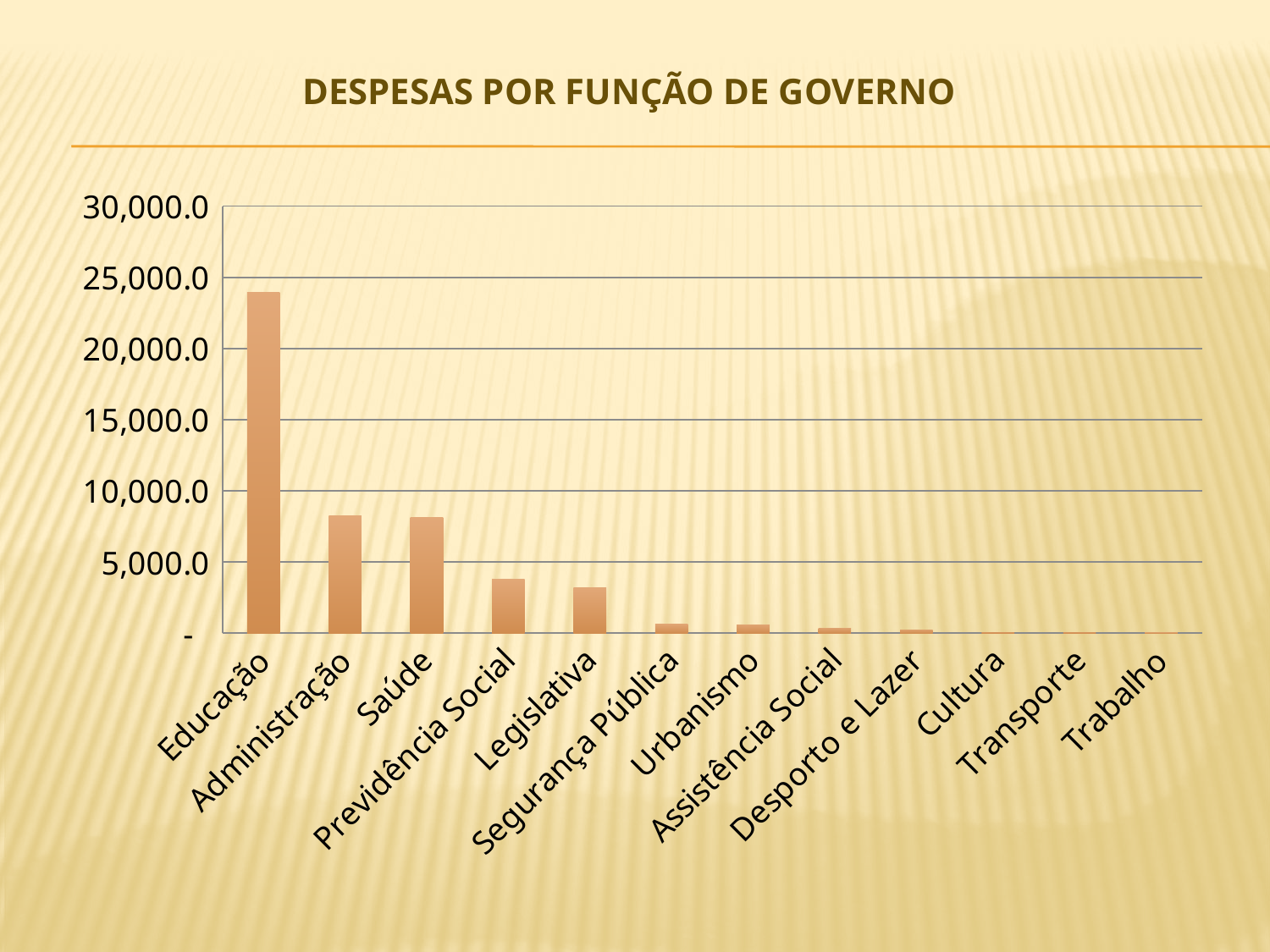
Which is larger, the value for Previdência Social or the value for Segurança Pública? Previdência Social Which is larger, the value for Educação or the value for Administração? Educação What is the title of the chart? DESPESAS POR FUNÇÃO DE GOVERNO Is the value for Legislativa greater or less than 5,000.0? less Is the value for Educação greater or less than 20,000.0? greater Is the value for Administração greater or less than 10,000.0? less Do the values generally rise or fall moving from left to right along the x axis? fall How many categories are shown on the x axis of the chart? 12 What kind of chart is shown on the slide? bar chart Which category has the highest value? Educação